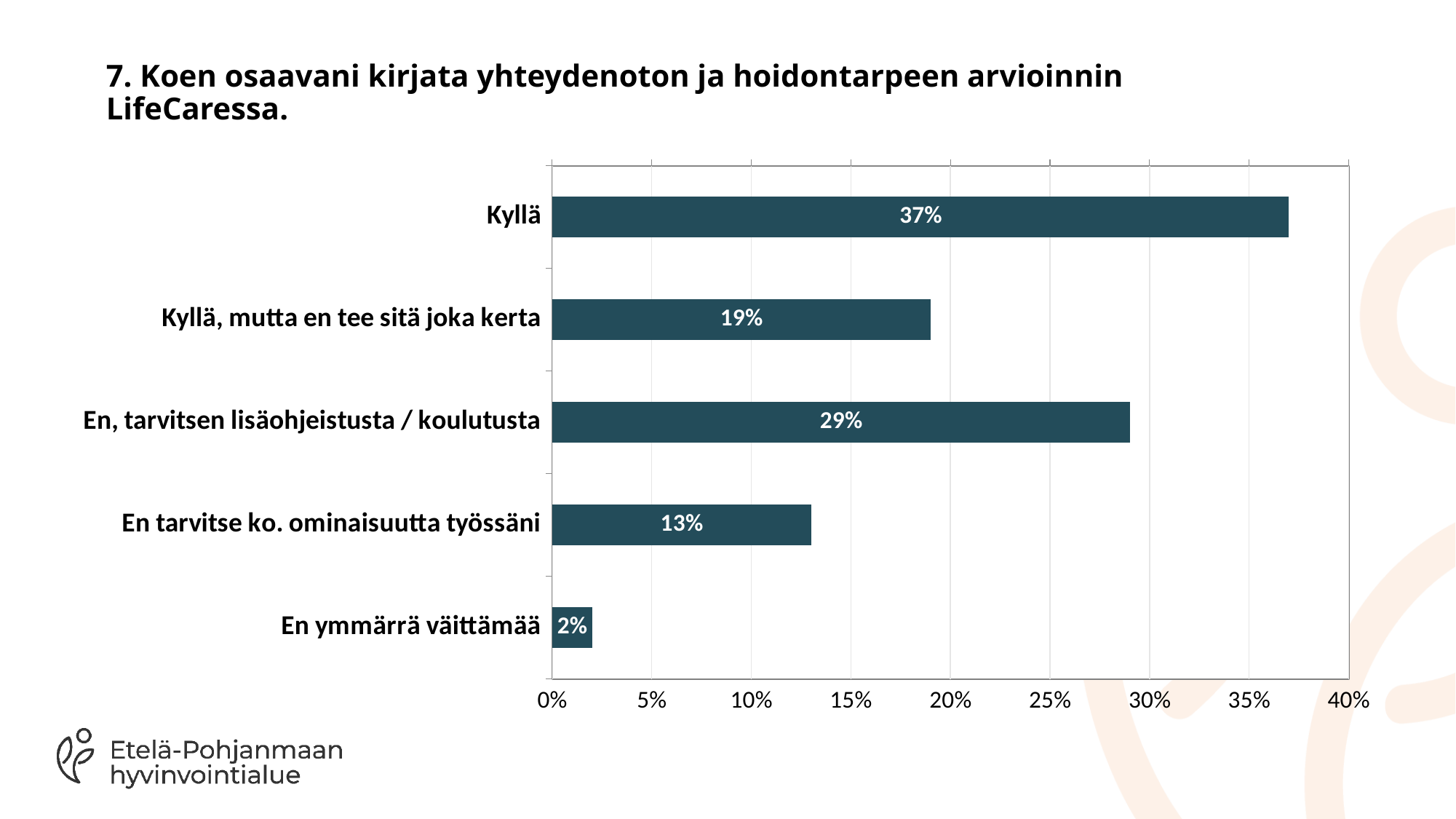
Which category has the highest value? Kyllä What is the value for "En ymmärrä väittämää"? 2% Which is larger: the value for "En, tarvitsen lisäohjeistusta / koulutusta" or the value for "En tarvitse ko. ominaisuutta työssäni"? En, tarvitsen lisäohjeistusta / koulutusta What is the value for "En, tarvitsen lisäohjeistusta / koulutusta"? 29% How many categories are shown in the chart? 5 What is the value for "Kyllä"? 37% What is the difference between the values for "En tarvitse ko. ominaisuutta työssäni" and "En ymmärrä väittämää"? 11% Is the value for "Kyllä, mutta en tee sitä joka kerta" greater or less than 20%? less What is the difference between the values for "Kyllä" and "Kyllä, mutta en tee sitä joka kerta"? 18% Which category has the lowest value? En ymmärrä väittämää What kind of chart is shown on the slide? bar chart What is the maximum value shown on the x axis? 40%